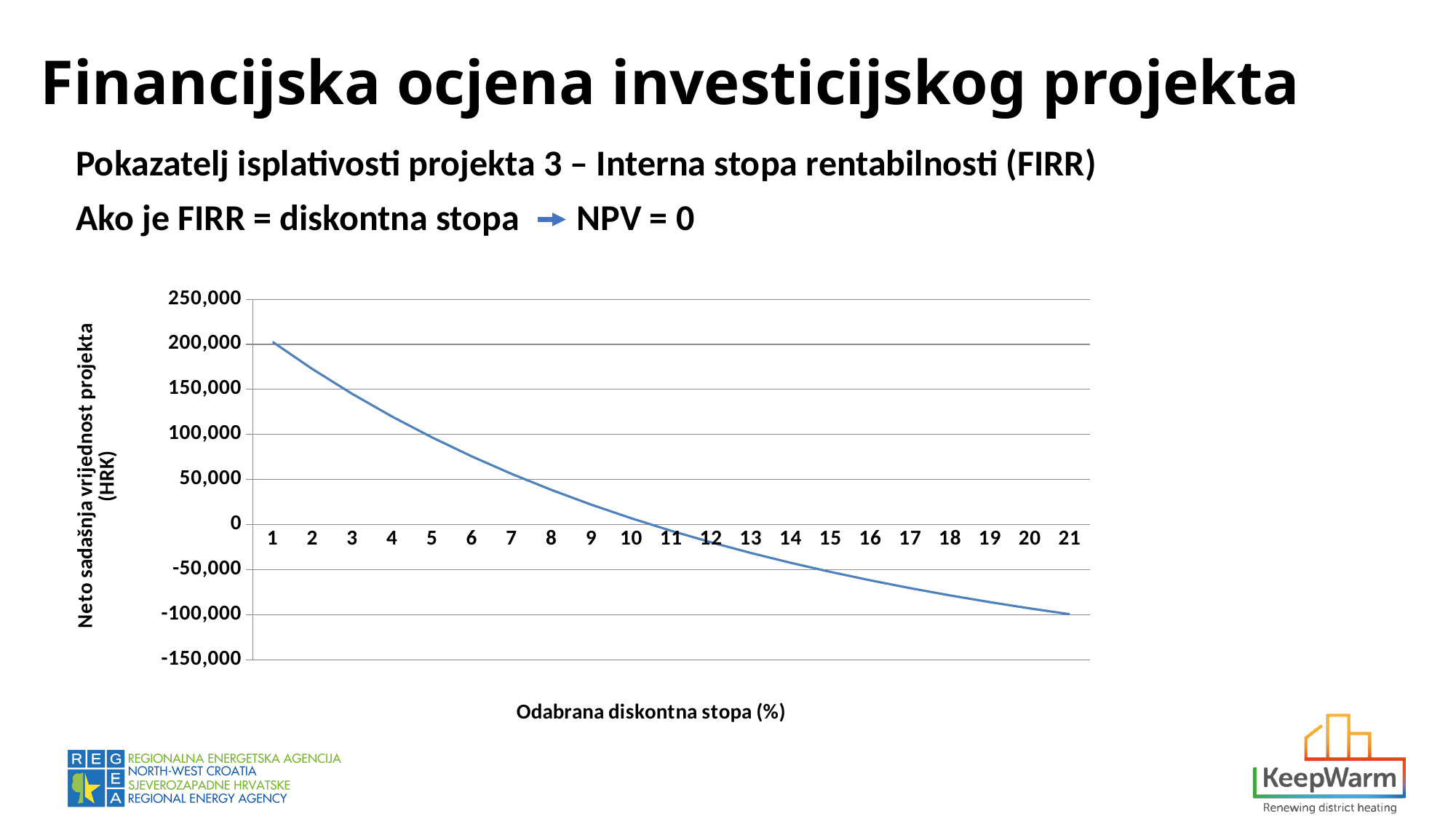
Is the net present value at a discount rate of 15 greater or less than 0? less Is the net present value at a discount rate of 5 greater or less than 50,000? greater Which has the larger net present value: a discount rate of 2 or a discount rate of 10? 2 Is the net present value at a discount rate of 20 greater or less than -50,000? less What kind of chart is shown on the slide? line chart What is the title of the x axis? Odabrana diskontna stopa (%) Does the net present value rise or fall as the discount rate increases along the x axis? fall At which discount rate is the net present value highest? 1 What is the title of the y axis? Neto sadašnja vrijednost projekta (HRK) How many discount rate values are plotted along the x axis? 21 At which discount rate is the net present value lowest? 21